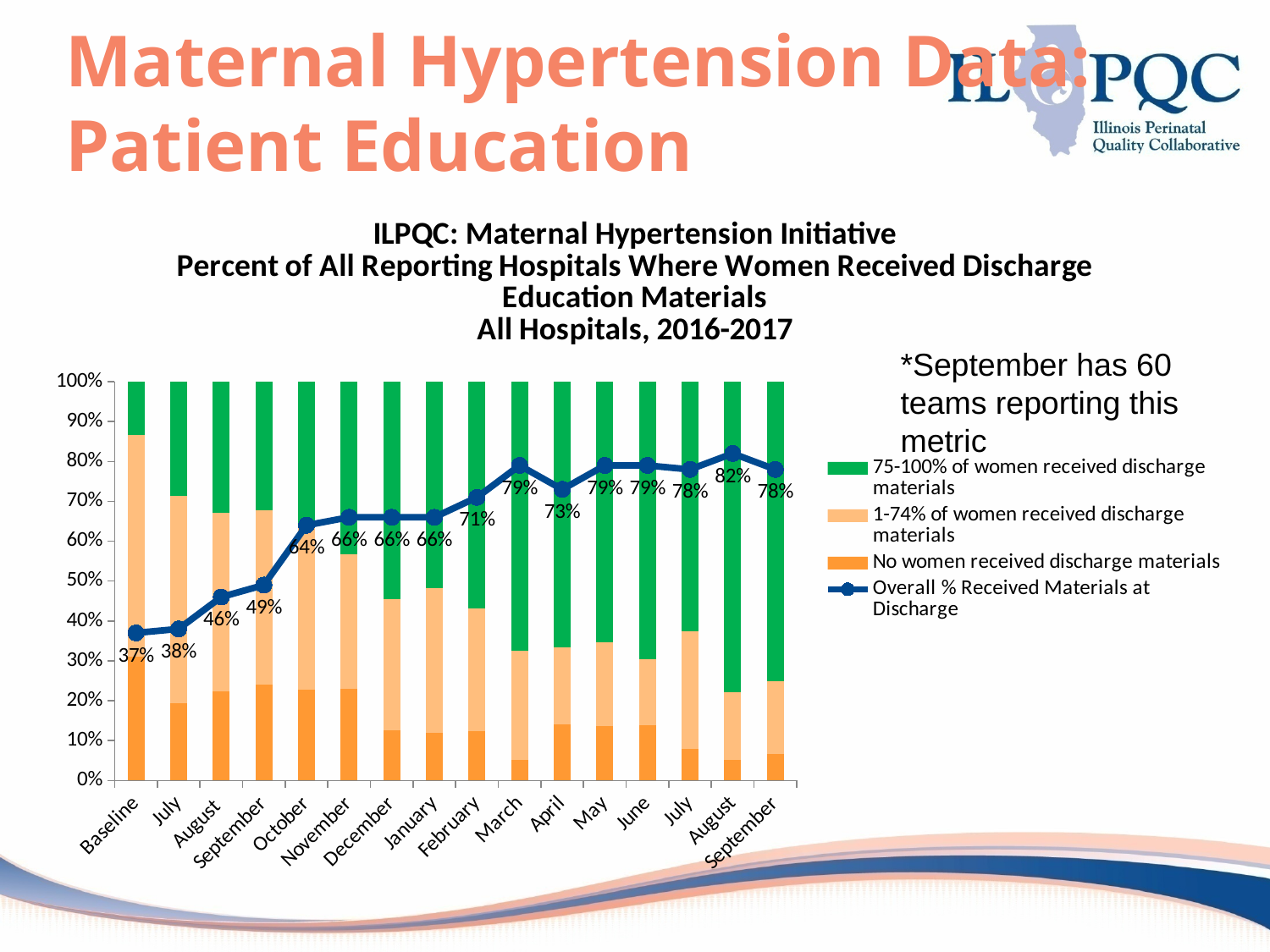
What is the Overall % Received Materials at Discharge value for February? 71% What is the difference between the Overall % Received Materials at Discharge values for March and April? 6 percentage points What is the Overall % Received Materials at Discharge value for October? 64% Which is larger, the Overall % Received Materials at Discharge value for September 2016 or for November? November What is the Overall % Received Materials at Discharge value for April? 73% Is the 'No women received discharge materials' segment for March greater or less than 10%? less What is the Overall % Received Materials at Discharge value at Baseline? 37% How many entries does the legend list? 4 How many categories are shown along the x axis? 16 Which month has the highest Overall % Received Materials at Discharge value? August (2017), 82% Does the Overall % Received Materials at Discharge line generally rise or fall from Baseline to the final September? rise Which point on the Overall % Received Materials at Discharge line has the lowest value? Baseline, 37%